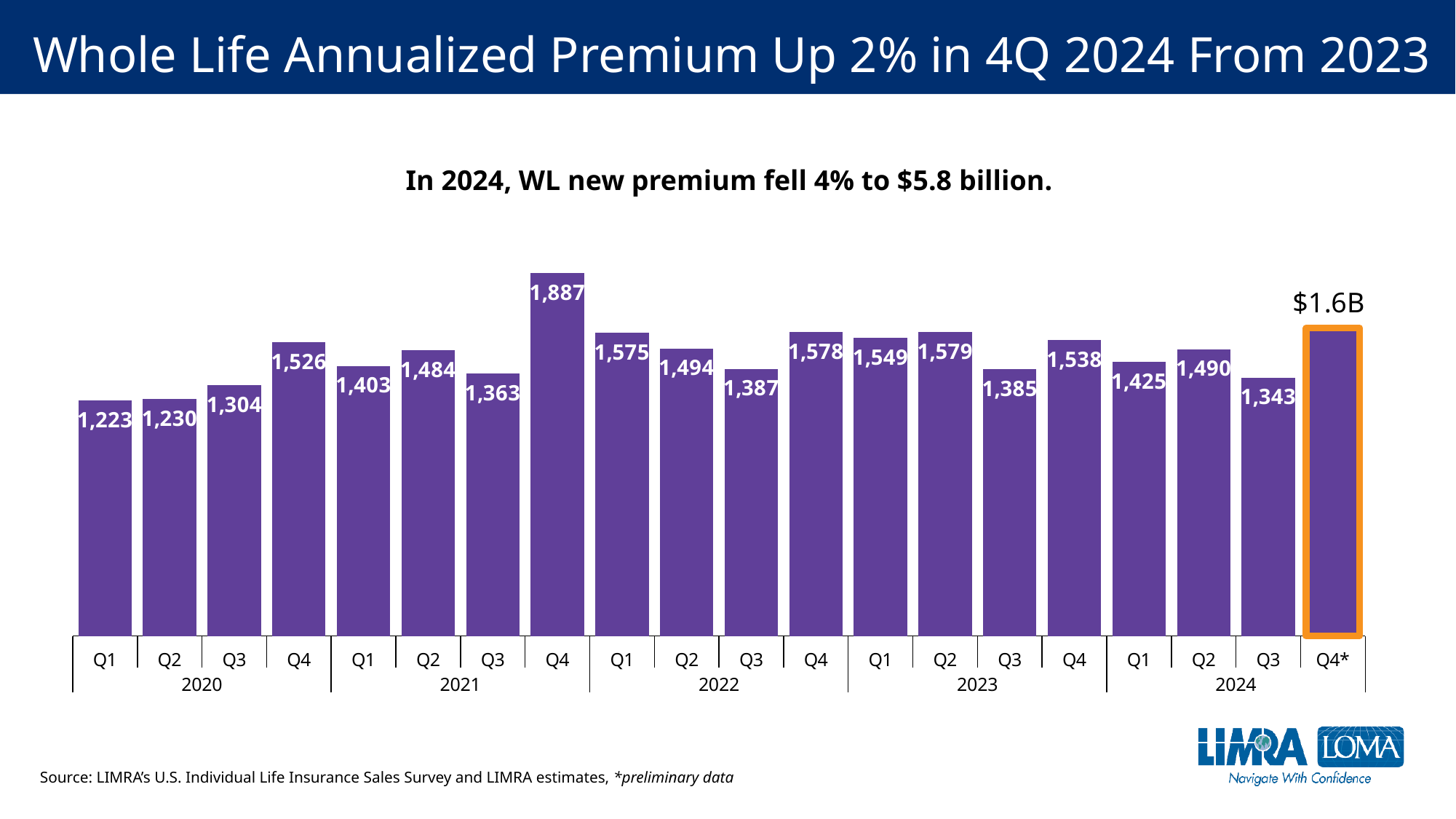
Which quarter has the lowest value in the chart? Q1 2020 What is the value for Q1 2020? 1,223 Do the values rise or fall from Q1 2020 to Q4 2020? Rise What is the value for Q4 2021? 1,887 How many bars are plotted in the chart? 20 Which quarter has the highest value in the chart? Q4 2021 Which bar is outlined in orange? Q4* 2024 Which is larger, the value for Q2 2022 or the value for Q2 2023? Q2 2023 What label is shown above the Q4* 2024 bar? $1.6B What is the value for Q3 2024? 1,343 What kind of chart is shown on the slide? Bar chart What is the difference between the Q4 2021 value and the Q3 2021 value? 524